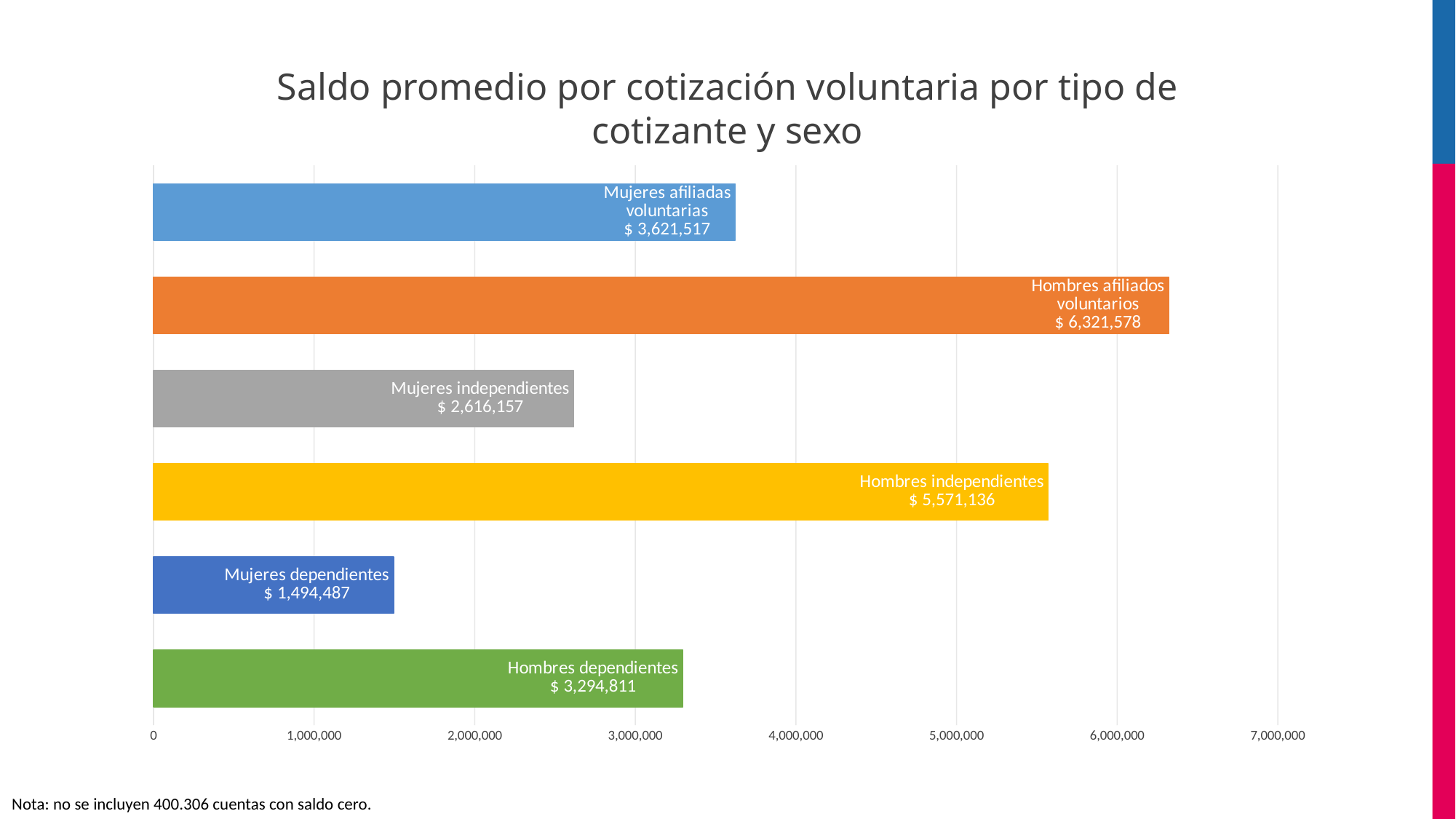
Is the value for Mujeres independientes greater or less than 3,000,000? less What is the difference between Hombres dependientes and Mujeres dependientes? $ 1,800,324 What is the value for Hombres independientes? $ 5,571,136 What is the title of the chart? Saldo promedio por cotización voluntaria por tipo de cotizante y sexo Which category has the highest value? Hombres afiliados voluntarios What is the value for Mujeres dependientes? $ 1,494,487 Which is larger, Mujeres afiliadas voluntarias or Hombres dependientes? Mujeres afiliadas voluntarias What is the value for Mujeres afiliadas voluntarias? $ 3,621,517 What kind of chart is shown on the slide? bar chart Which category has the lowest value? Mujeres dependientes What is the difference between Hombres afiliados voluntarios and Mujeres afiliadas voluntarias? $ 2,700,061 How many bars are shown in the chart? 6